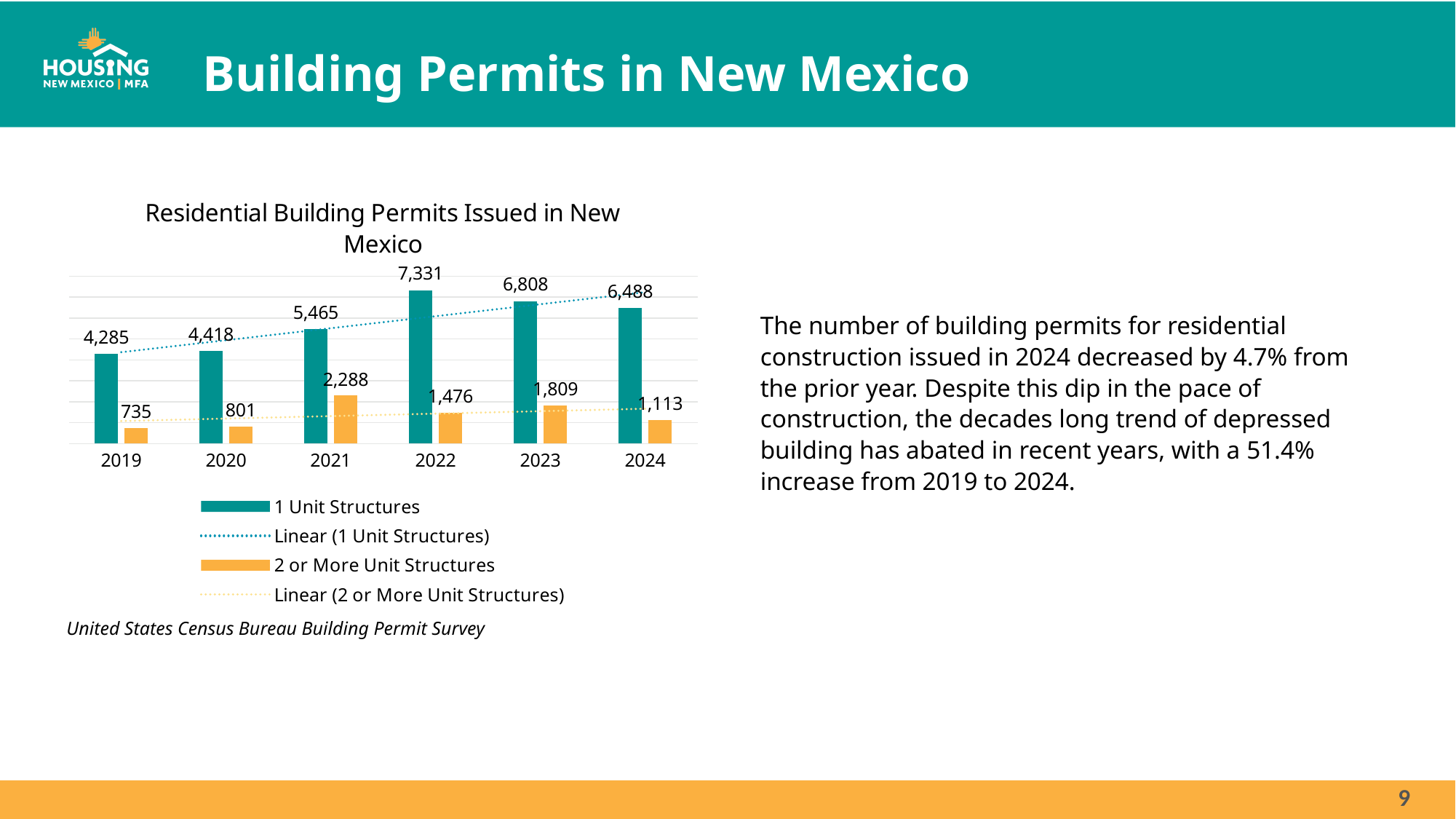
What is the value for 2 or More Unit Structures in 2024? 1,113 What is the value for 1 Unit Structures in 2019? 4,285 Which year has the highest value for 1 Unit Structures? 2022 What is the difference between the 1 Unit Structures values for 2023 and 2024? 320 What kind of chart is this? Bar chart Which year has the lowest value for 2 or More Unit Structures? 2019 What is the value for 1 Unit Structures in 2022? 7,331 How many entries does the legend list? 4 What is the value for 2 or More Unit Structures in 2021? 2,288 What is the total of the 1 Unit Structures and 2 or More Unit Structures values for 2020? 5,219 How many years are shown on the x axis? 6 Which is larger, the 2 or More Unit Structures value for 2022 or for 2023? 2023